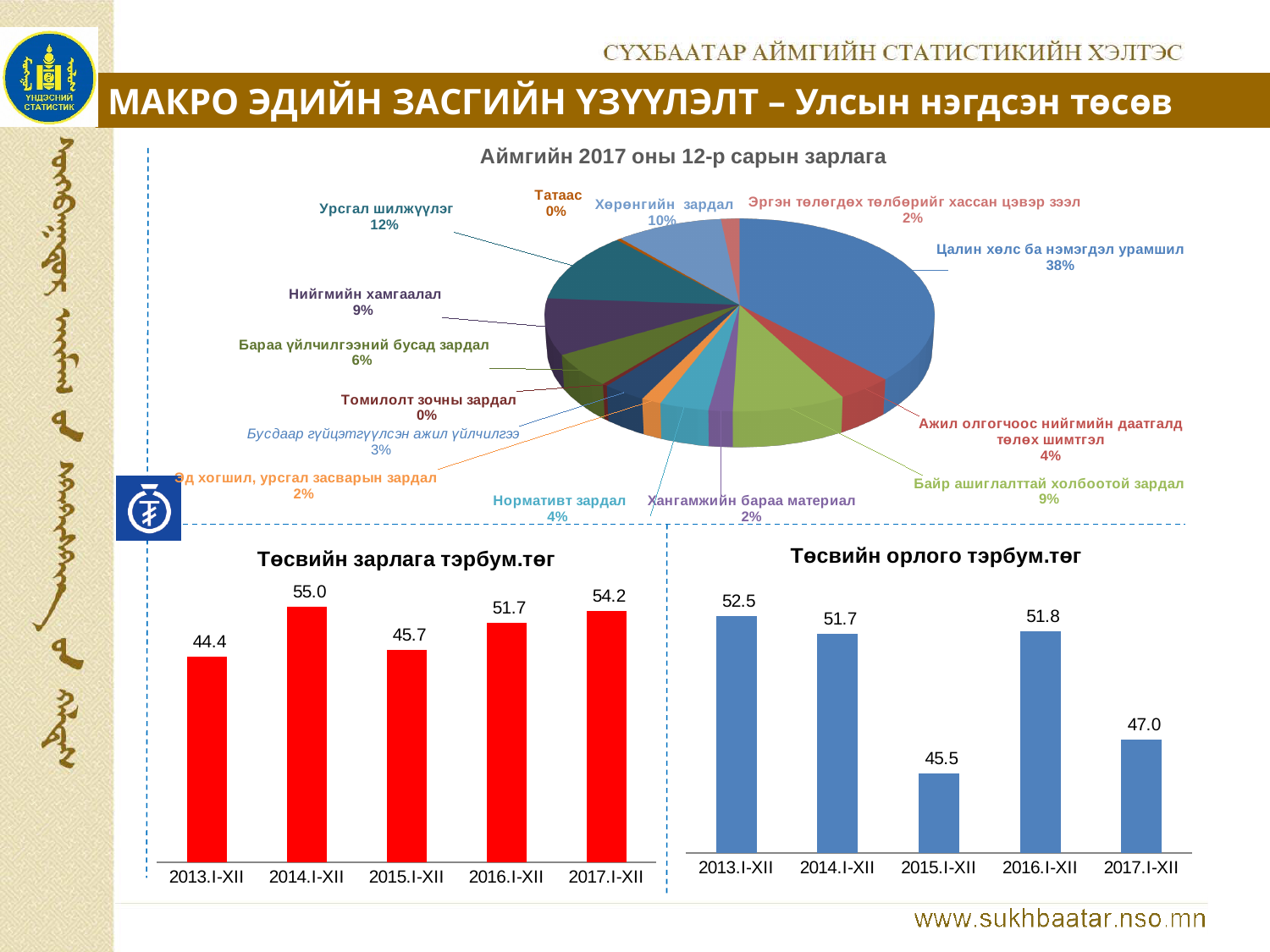
In the chart 'Төсвийн орлого тэрбум.төг', what is the value for 2015.I-XII? 45.5 In the chart 'Төсвийн орлого тэрбум.төг', which year has the highest value? 2013.I-XII In the pie chart 'Аймгийн 2017 оны 12-р сарын зарлага', what share is 'Хөрөнгийн зардал'? 10% In the chart 'Төсвийн зарлага тэрбум.төг', how many bars are plotted? 5 What type of chart is 'Төсвийн орлого тэрбум.төг'? bar chart In the pie chart 'Аймгийн 2017 оны 12-р сарын зарлага', what share is 'Урсгал шилжүүлэг'? 12% In the pie chart 'Аймгийн 2017 оны 12-р сарын зарлага', what share is 'Цалин хөлс ба нэмэгдэл урамшил'? 38% In the chart 'Төсвийн зарлага тэрбум.төг', which year has the lowest value? 2013.I-XII In the chart 'Төсвийн зарлага тэрбум.төг', what is the value for 2014.I-XII? 55.0 In the pie chart 'Аймгийн 2017 оны 12-р сарын зарлага', which category has the largest share? Цалин хөлс ба нэмэгдэл урамшил In the chart 'Төсвийн орлого тэрбум.төг', is the value for 2016.I-XII larger or smaller than the value for 2017.I-XII? larger In the chart 'Төсвийн зарлага тэрбум.төг', what is the difference between the values for 2017.I-XII and 2013.I-XII? 9.8